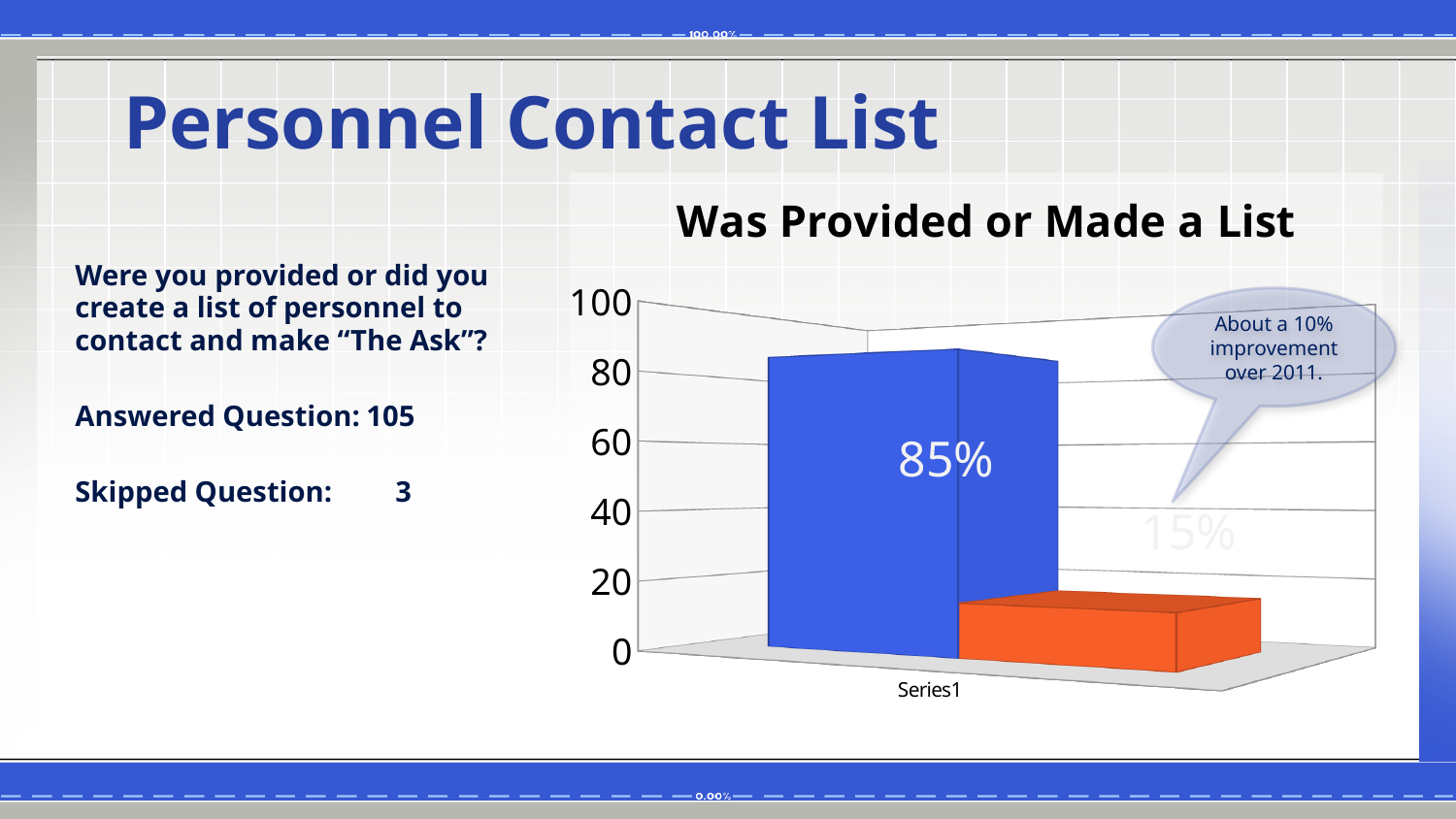
Is the value of the blue bar greater or less than 80? greater What kind of chart is shown on the slide? bar chart What label appears below the bars on the horizontal axis? Series1 What value is printed on the blue bar? 85% What value is printed on the orange bar? 15% How many bars are plotted in the chart? 2 What is the difference between the blue bar's value and the orange bar's value? 70% What is the title of the chart? Was Provided or Made a List Is the value of the orange bar greater or less than 20? less What is the total of the two bar values shown? 100% What is the highest value shown on the vertical axis? 100 Which bar is taller, the blue bar or the orange bar? the blue bar